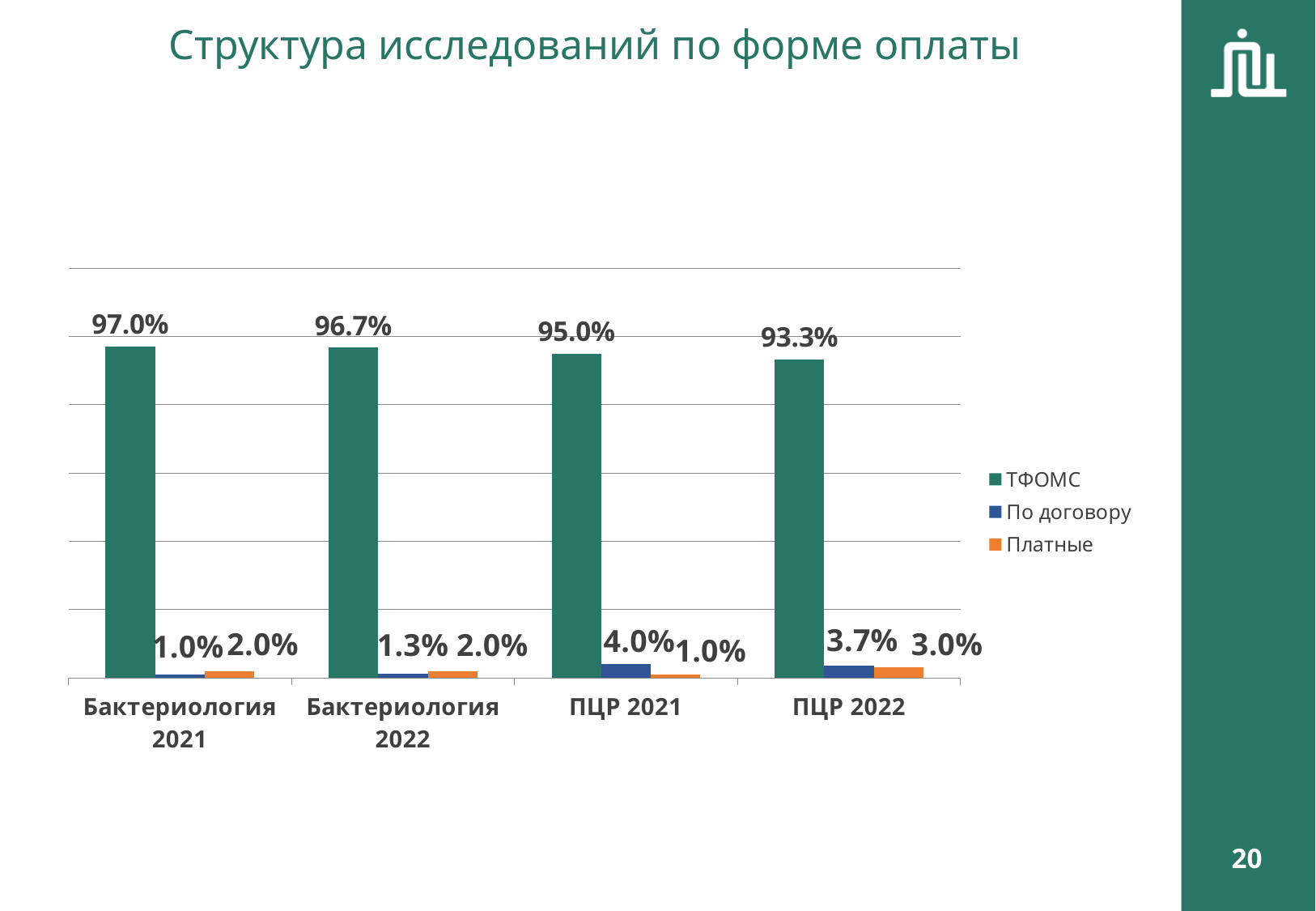
What is the ТФОМС value for Бактериология 2021? 97.0% What is the title of the chart? Структура исследований по форме оплаты What is the Платные value for ПЦР 2022? 3.0% What is the По договору value for Бактериология 2022? 1.3% What is the difference between the ТФОМС values for Бактериология 2021 and ПЦР 2022? 3.7% Which category has the lowest ТФОМС value? ПЦР 2022 What kind of chart is shown on the slide? Bar chart How many series does the legend list? 3 Which category has the highest По договору value? ПЦР 2021 How many categories are shown on the x axis? 4 Which is larger: the Платные value for ПЦР 2021 or for ПЦР 2022? ПЦР 2022 What is the По договору value for ПЦР 2021? 4.0%